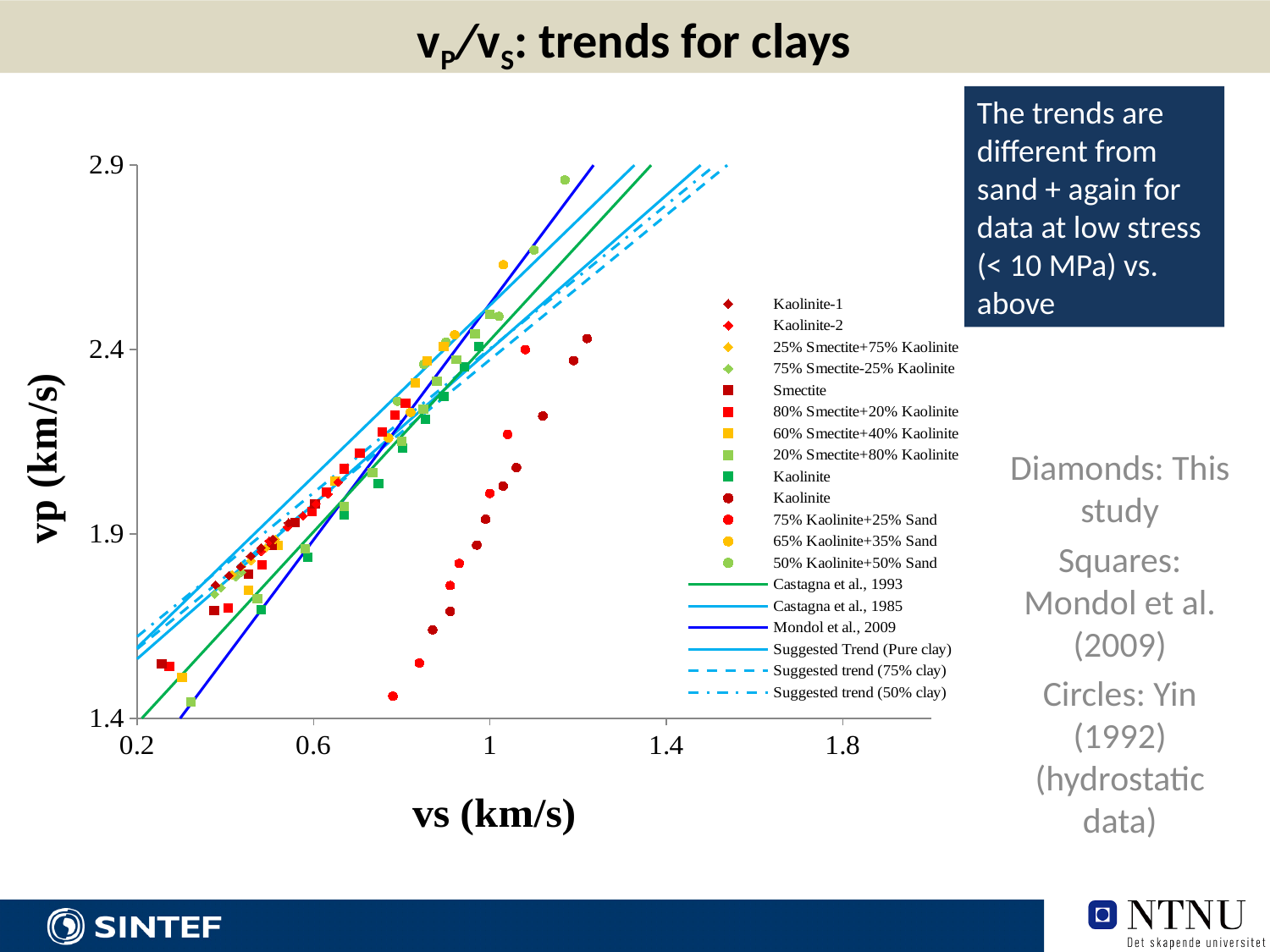
Is the vp value of the highest 50% Kaolinite+50% Sand point (green circle near the top of the chart) greater or less than 2.4? greater Which trend line in the chart is the steepest? Mondol et al., 2009 How many entries does the chart legend list in total? 19 What is the lowest value shown on the x axis (vs) of the chart? 0.2 Do the vp values generally rise or fall as vs increases along the x axis? Rise What is the label of the y axis of the chart? vp (km/s) What kind of chart is shown on the slide? Scatter chart Is the vp value of the lowest 75% Kaolinite+25% Sand point (red circle near vs = 0.8) greater or less than 1.9? less What is the highest value shown on the y axis (vp) of the chart? 2.9 How many trend-line series (as opposed to marker series) does the legend list? 6 What is the label of the x axis of the chart? vs (km/s) Which legend entry is drawn as a dash-dot line? Suggested trend (50% clay)